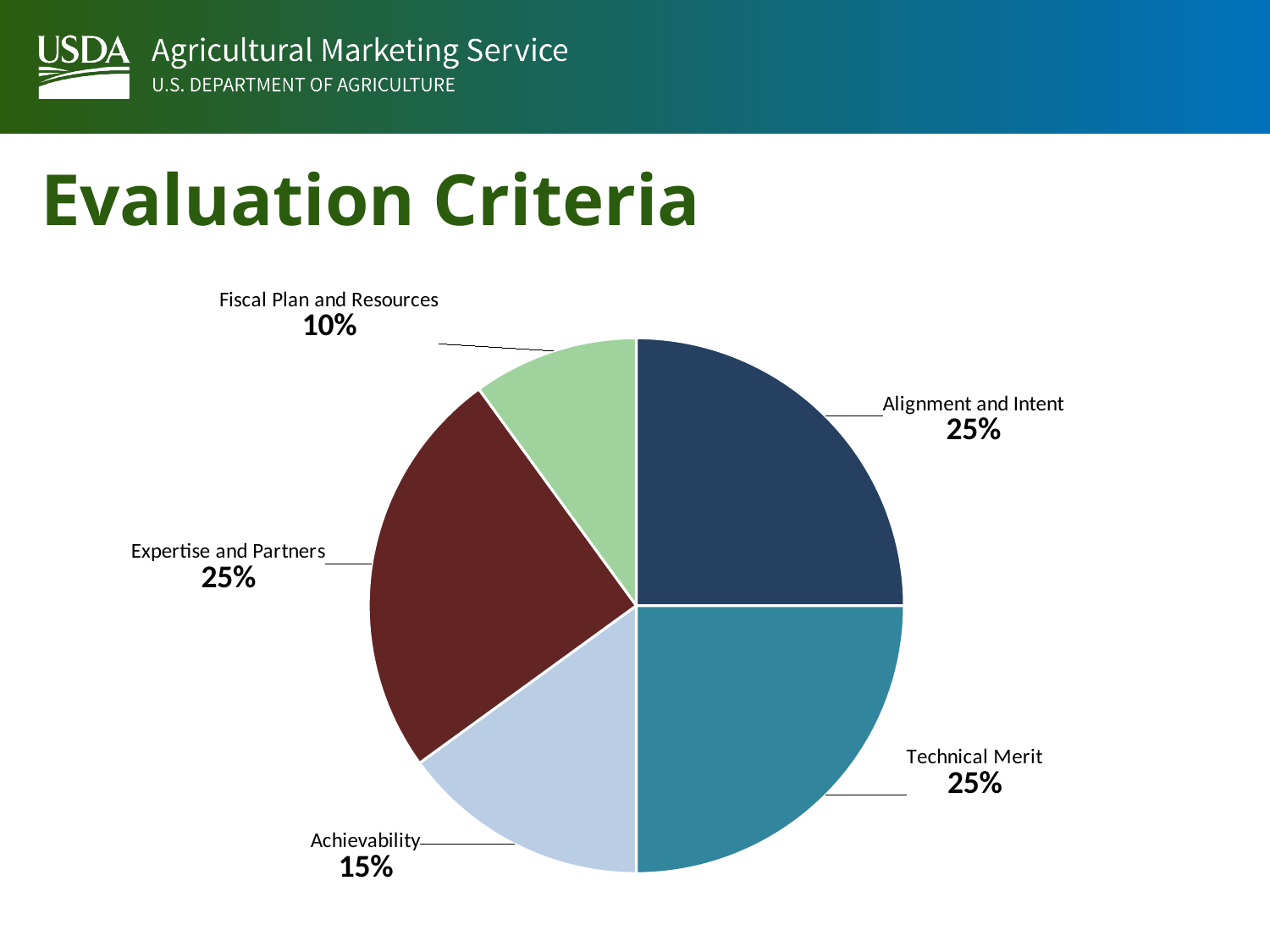
Which is larger, the value for Achievability or the value for Fiscal Plan and Resources? Achievability What is the value for Expertise and Partners? 25% What is the value for Technical Merit? 25% What is the difference between the values for Alignment and Intent and Achievability? 10% Which category has the smallest slice of the pie? Fiscal Plan and Resources What is the difference between the values for Achievability and Fiscal Plan and Resources? 5% What colour is the Fiscal Plan and Resources slice? light green What kind of chart is shown on the slide? pie chart What is the value for Achievability? 15% What share of the pie does Fiscal Plan and Resources represent? 10% How many categories are shown in the pie chart? 5 What is the title of the slide containing the pie chart? Evaluation Criteria